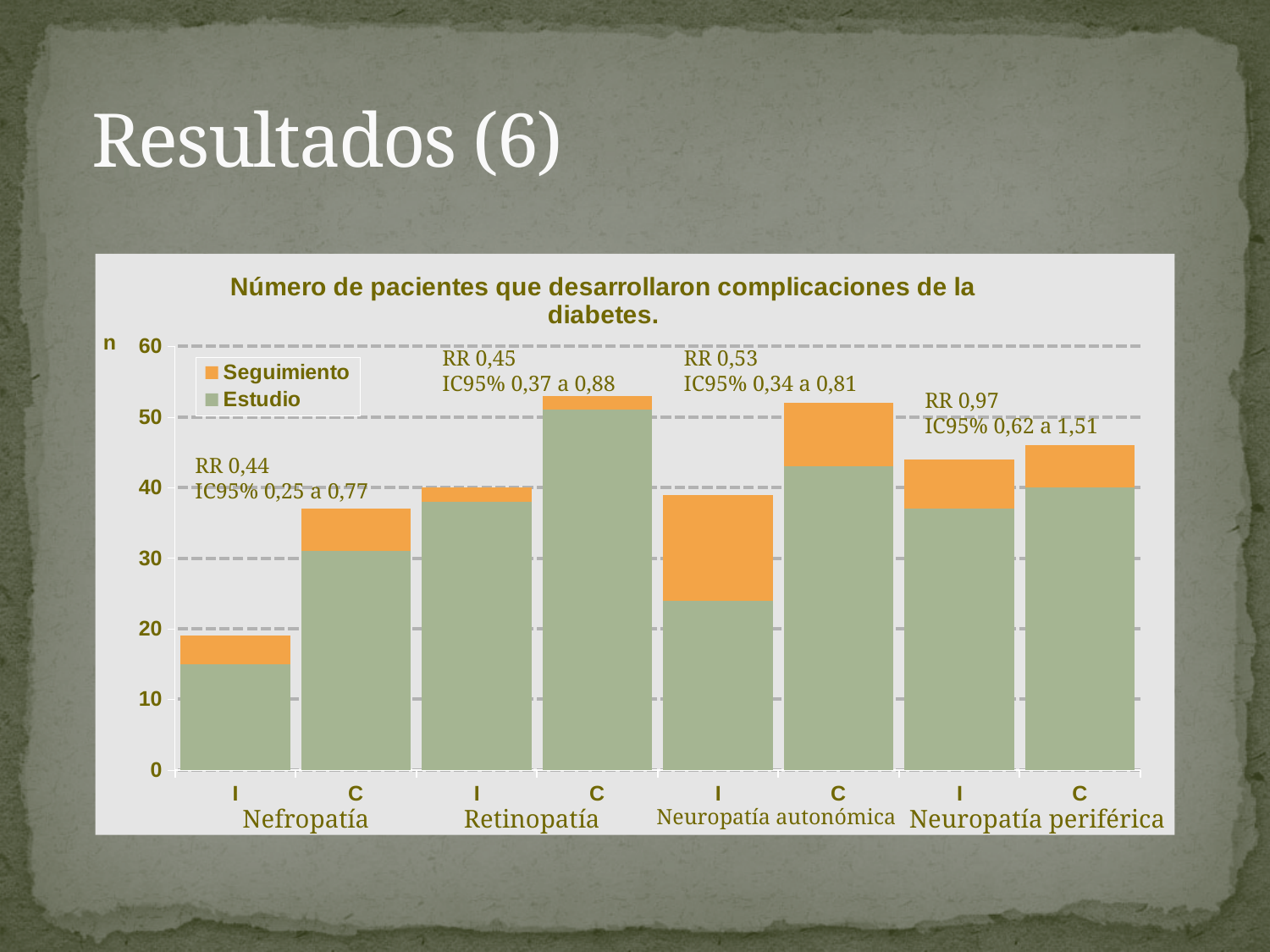
Is the total for the Retinopatía C bar greater or less than 50? greater What is the title of the chart? Número de pacientes que desarrollaron complicaciones de la diabetes. How many stacked bars are plotted in total? 8 Within Neuropatía autonómica, which bar is taller, I or C? C How many series does the legend list? 2 Is the total for the Nefropatía C bar greater or less than 30? greater Is the total for the Nefropatía I bar greater or less than 30? less Which bar has the lowest total height? Nefropatía I What are the two series named in the legend? Seguimiento and Estudio What kind of chart is shown on the slide? Stacked bar chart How many complication groups are shown along the x axis? 4